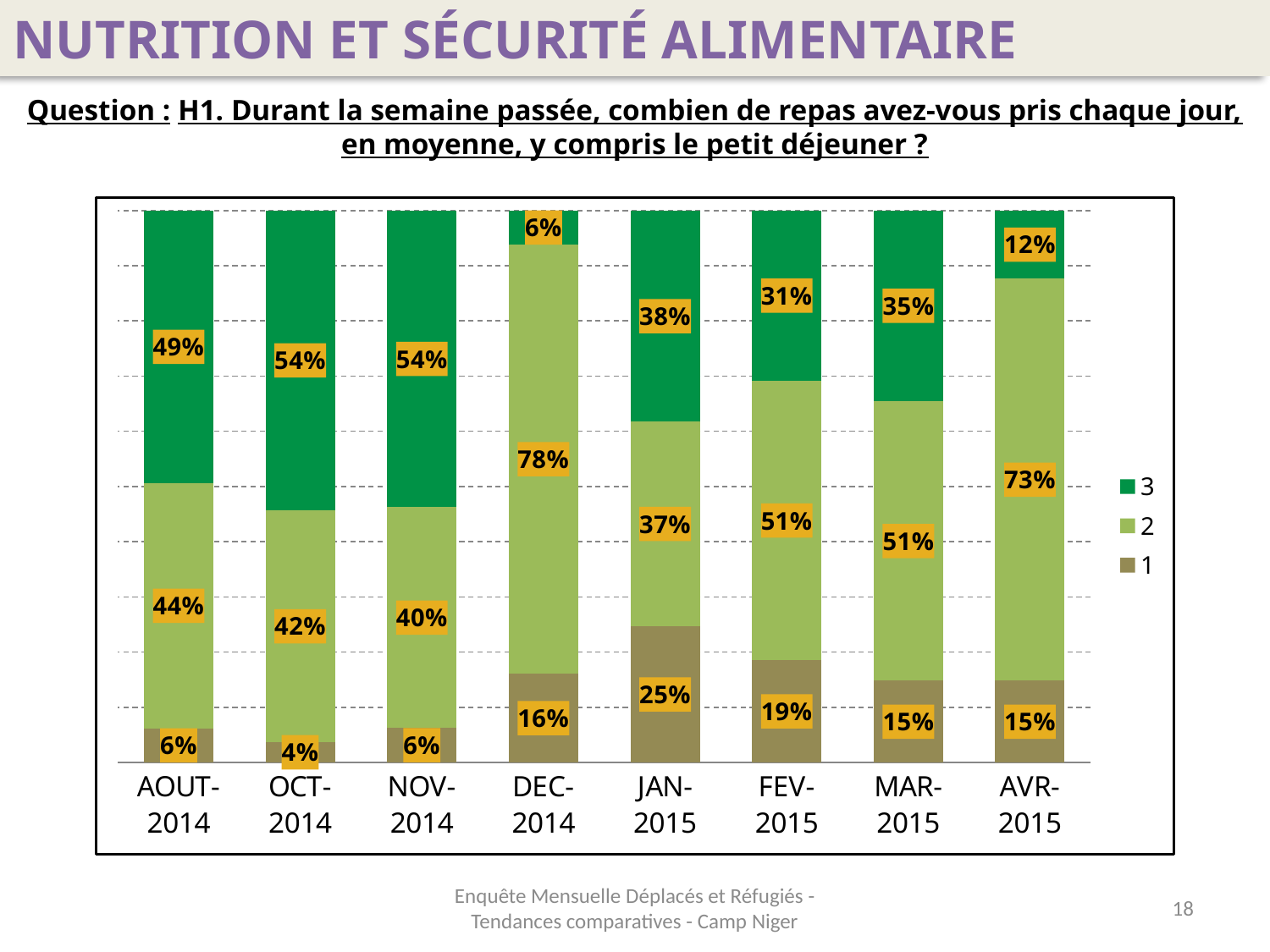
What is the value for series 1 in JAN-2015? 25% How many series does the legend list? 3 Which is larger: series 1 in JAN-2015 or series 1 in FEV-2015? JAN-2015 What kind of chart is shown on the slide? Stacked bar chart What is the value for series 3 in AVR-2015? 12% Which month has the lowest value for series 3? DEC-2014 What is the total of the stacked bar for NOV-2014? 100% How many months are shown on the x axis? 8 Which month has the lowest value for series 1? OCT-2014 Which month has the highest value for series 2? DEC-2014 What is the value for series 2 in DEC-2014? 78% What is the difference between the series 3 values for OCT-2014 and FEV-2015? 23%